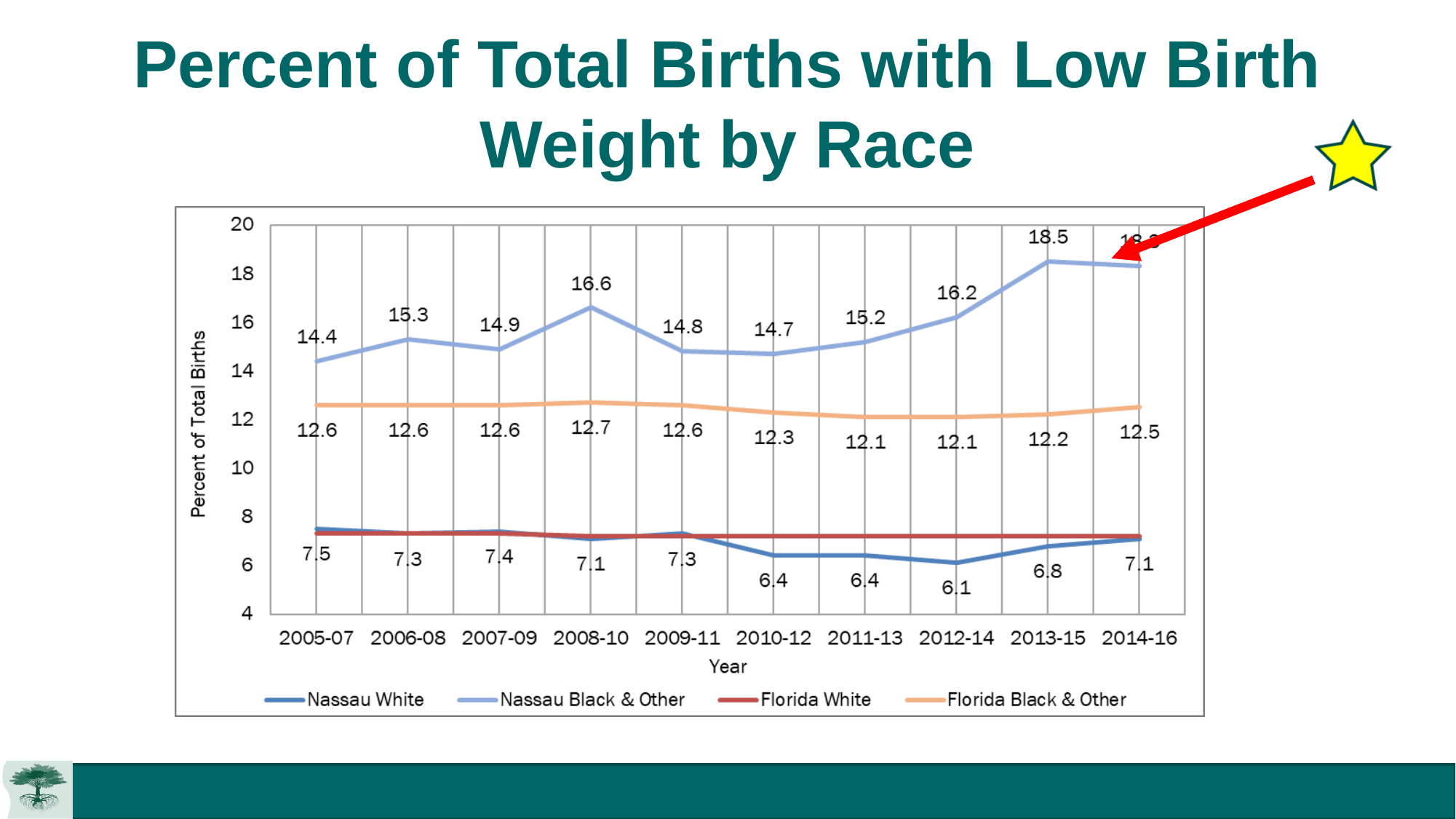
Is the value for Florida White in 2014-16 greater or less than 8? less What type of chart is shown on the slide? line chart What is the value for Florida Black & Other in 2014-16? 12.5 How many year periods are shown on the x axis? 10 In which year period is the Nassau White value lowest? 2012-14 What is the value for Nassau Black & Other in 2008-10? 16.6 Which is larger in 2010-12: the Nassau White value or the Florida Black & Other value? Florida Black & Other How many series does the legend list? 4 What is the difference between the Nassau Black & Other value in 2013-15 and in 2005-07? 4.1 What is the value for Nassau White in 2012-14? 6.1 What is the label of the y axis? Percent of Total Births In which year period is the Nassau Black & Other value highest? 2013-15